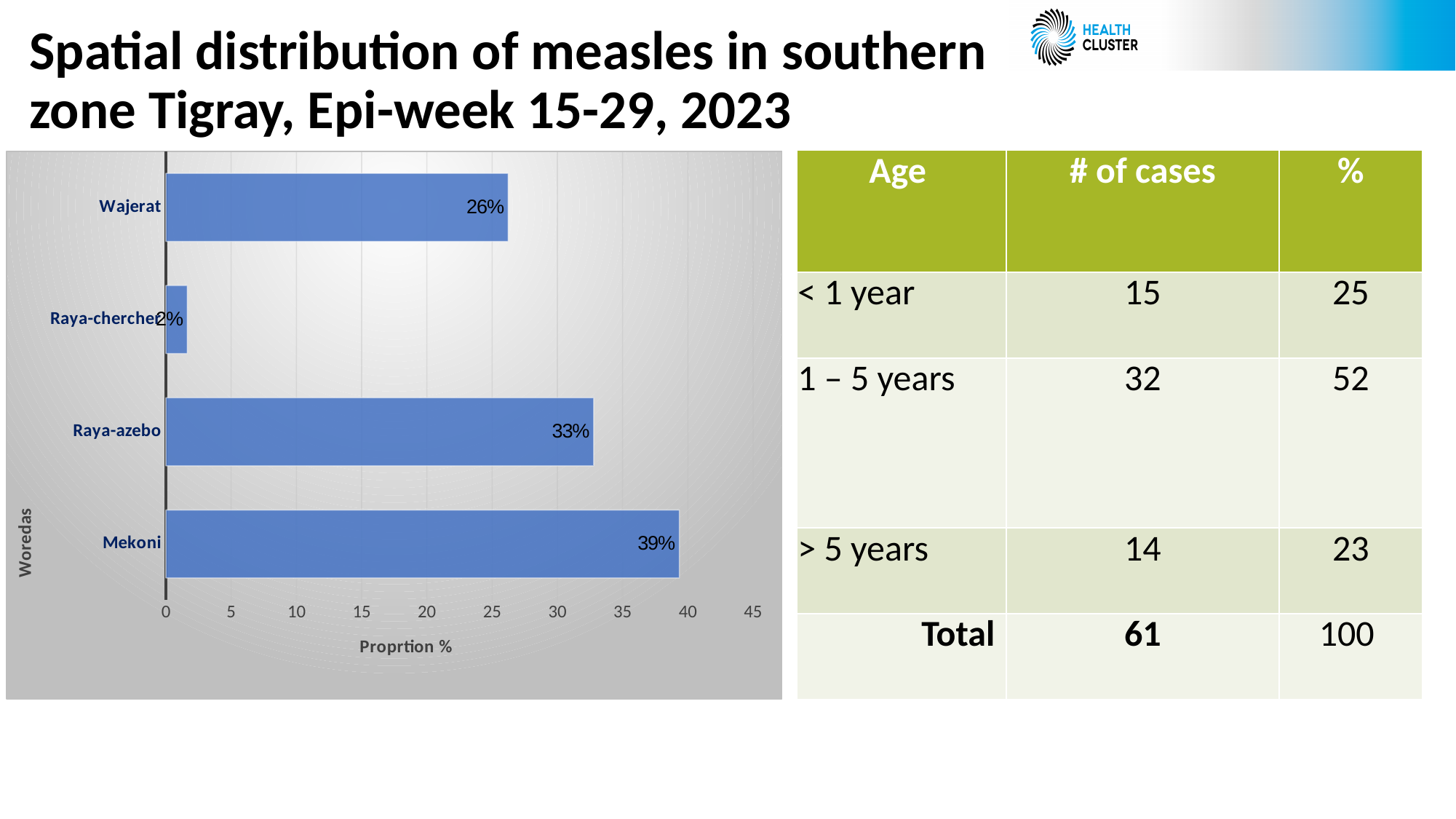
Which woreda has the highest proportion? Mekoni How many woredas are shown in the chart? 4 What is the value for Wajerat? 26% Which woreda has the lowest proportion? Raya-chercher What kind of chart is shown on the slide? bar chart What is the title of the horizontal axis of the chart? Proprtion % What is the difference between the values for Raya-azebo and Wajerat? 7% Which is larger, the value for Raya-azebo or the value for Wajerat? Raya-azebo What is the difference between the values for Mekoni and Wajerat? 13% What is the value for Mekoni? 39% Is the value for Mekoni greater or less than 35? greater What is the value for Raya-azebo? 33%